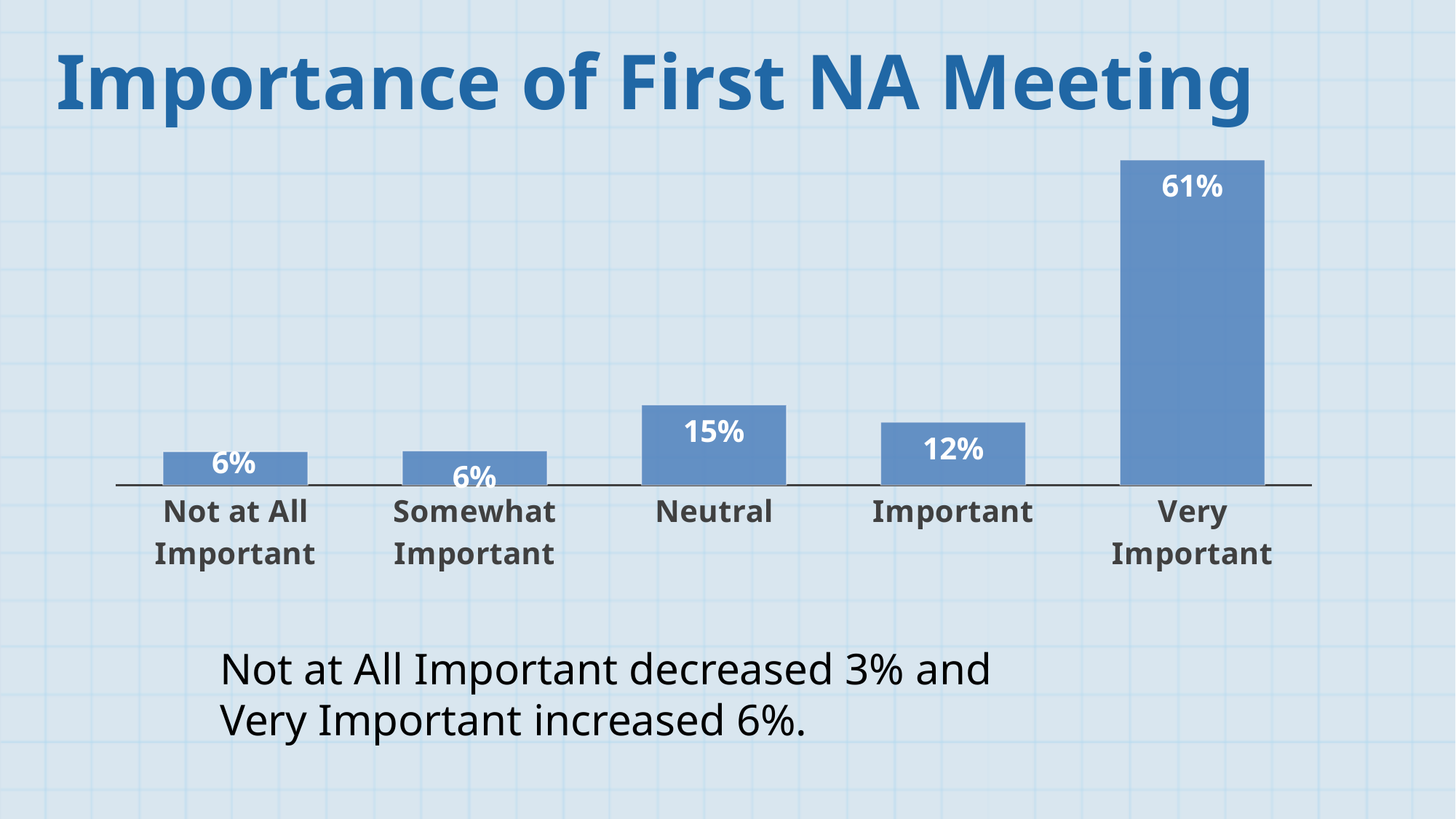
What is the value shown for Somewhat Important? 6% What percentage of respondents rated their first NA meeting as Very Important? 61% What is the value shown for Neutral? 15% Which is larger, the value for Neutral or the value for Important? Neutral Which category has the highest value? Very Important What is the difference between the Very Important and Neutral values? 46% What kind of chart is shown on the slide? Bar chart What is the value shown for Important? 12% According to the note below the chart, by how much did Very Important increase? 6% What is the difference between the Neutral and Important values? 3% What is the title of the slide? Importance of First NA Meeting How many categories are shown on the x axis? 5